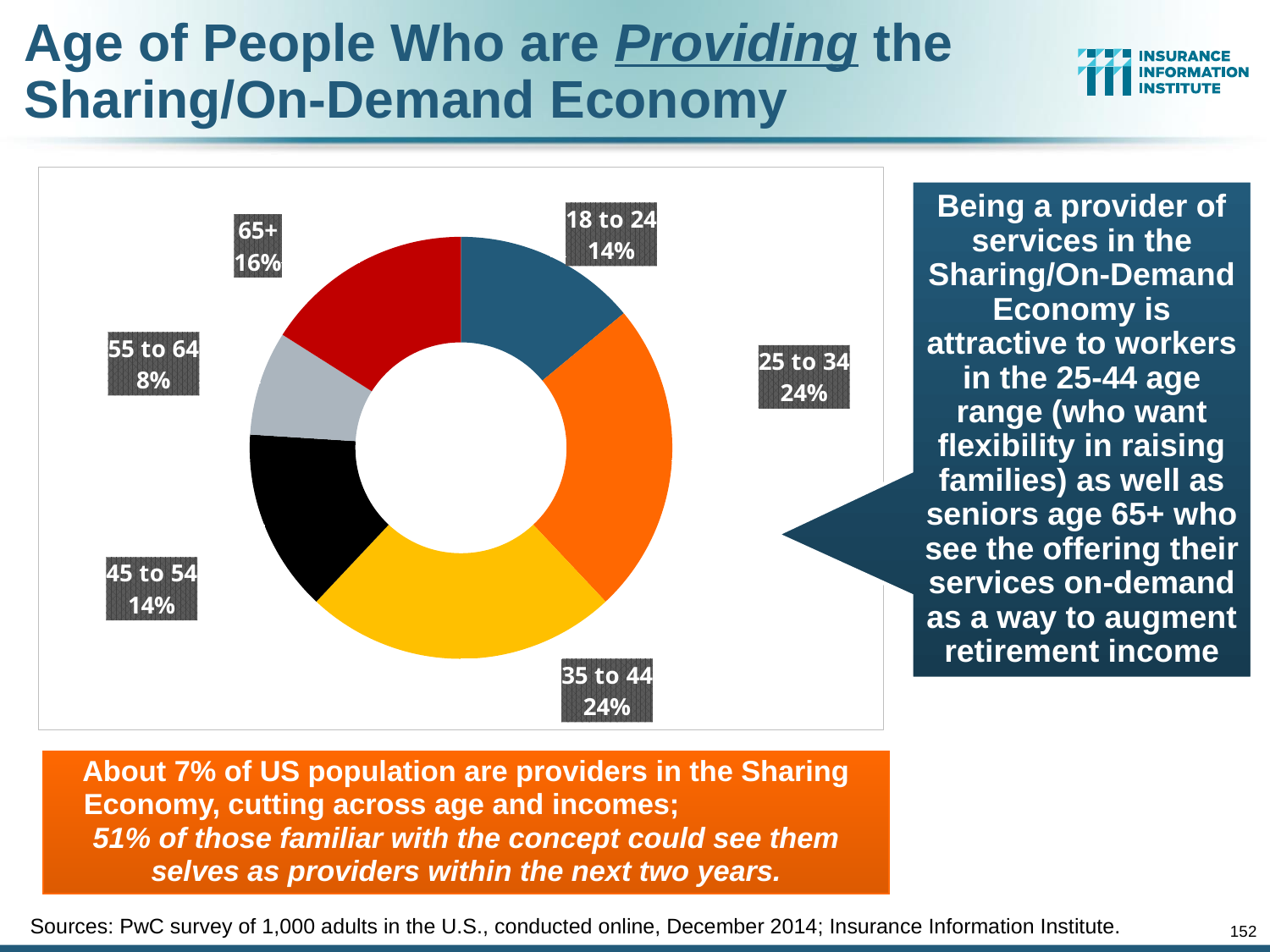
What share of providers are aged 65+? 16% What percentage of providers are in the 25 to 34 age group? 24% Which has a larger share of providers, the 25 to 34 group or the 55 to 64 group? 25 to 34 What type of chart is used to show the age of providers? Pie chart (donut) What is the difference in percentage points between the 35 to 44 group and the 45 to 54 group? 10 Which age group has the smallest share of providers? 55 to 64 What percentage of providers are aged 55 to 64? 8% Which has a larger share of providers, the 65+ group or the 18 to 24 group? 65+ What is the difference in percentage points between the 65+ group and the 55 to 64 group? 8 What share of providers are aged 18 to 24? 14% What colour is the slice for the 35 to 44 age group? Yellow How many age groups are shown in the chart? 6